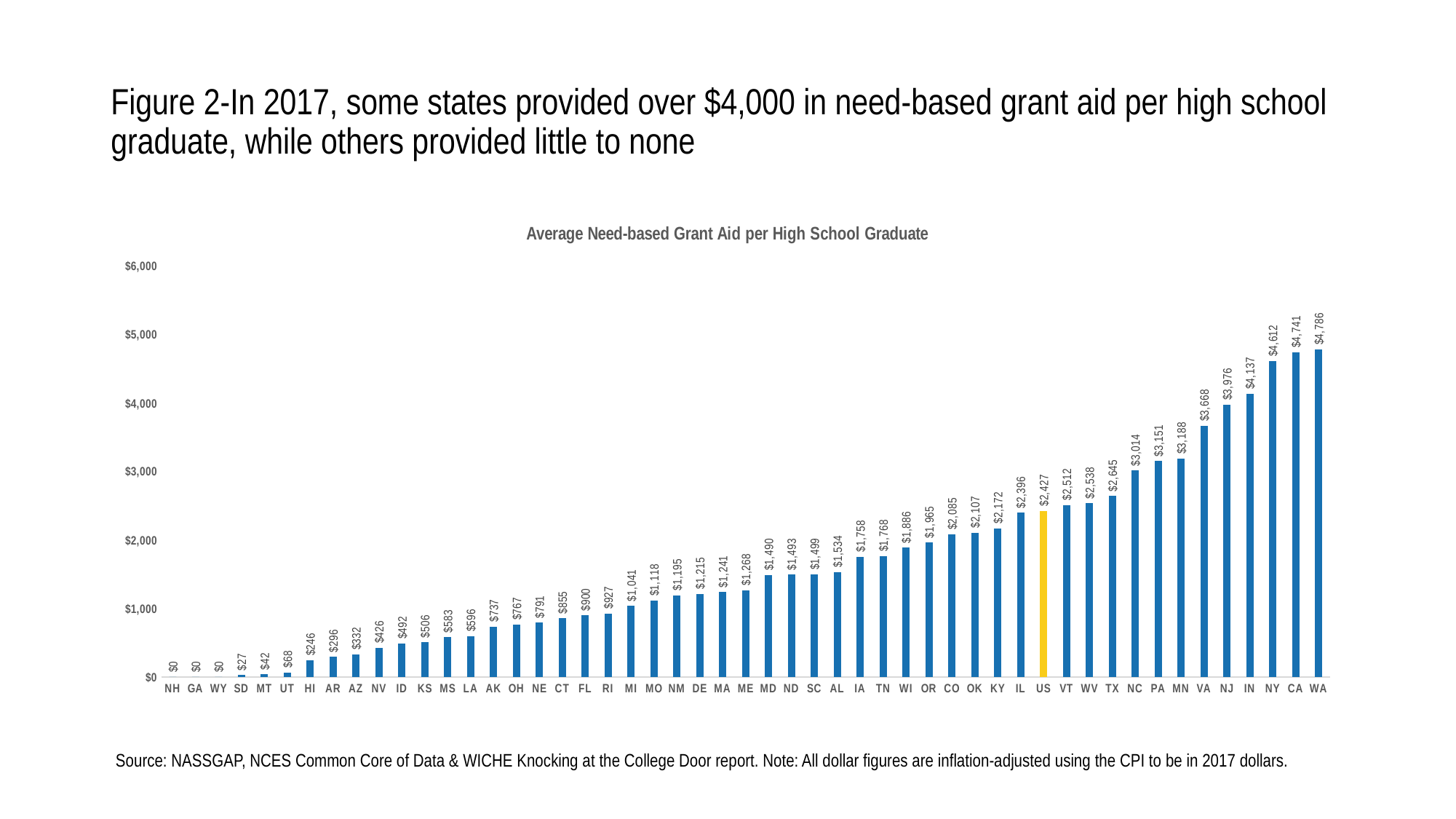
Is the value for NC greater or less than $3,000? greater How many bars are plotted in the chart? 51 Which bar is highlighted in yellow rather than blue? US Which state has the highest average need-based grant aid per high school graduate? WA What is the average need-based grant aid per high school graduate for the US bar? $2,427 What is the difference between the values for WA and CA? $45 What kind of chart is shown on the slide? Bar chart What is the value shown for Texas (TX)? $2,645 Which has a larger value, NJ or VA? NJ Do the values rise or fall moving from left to right along the x axis? Rise What is the value shown for Washington (WA)? $4,786 What is the difference between the values for NY and IN? $475